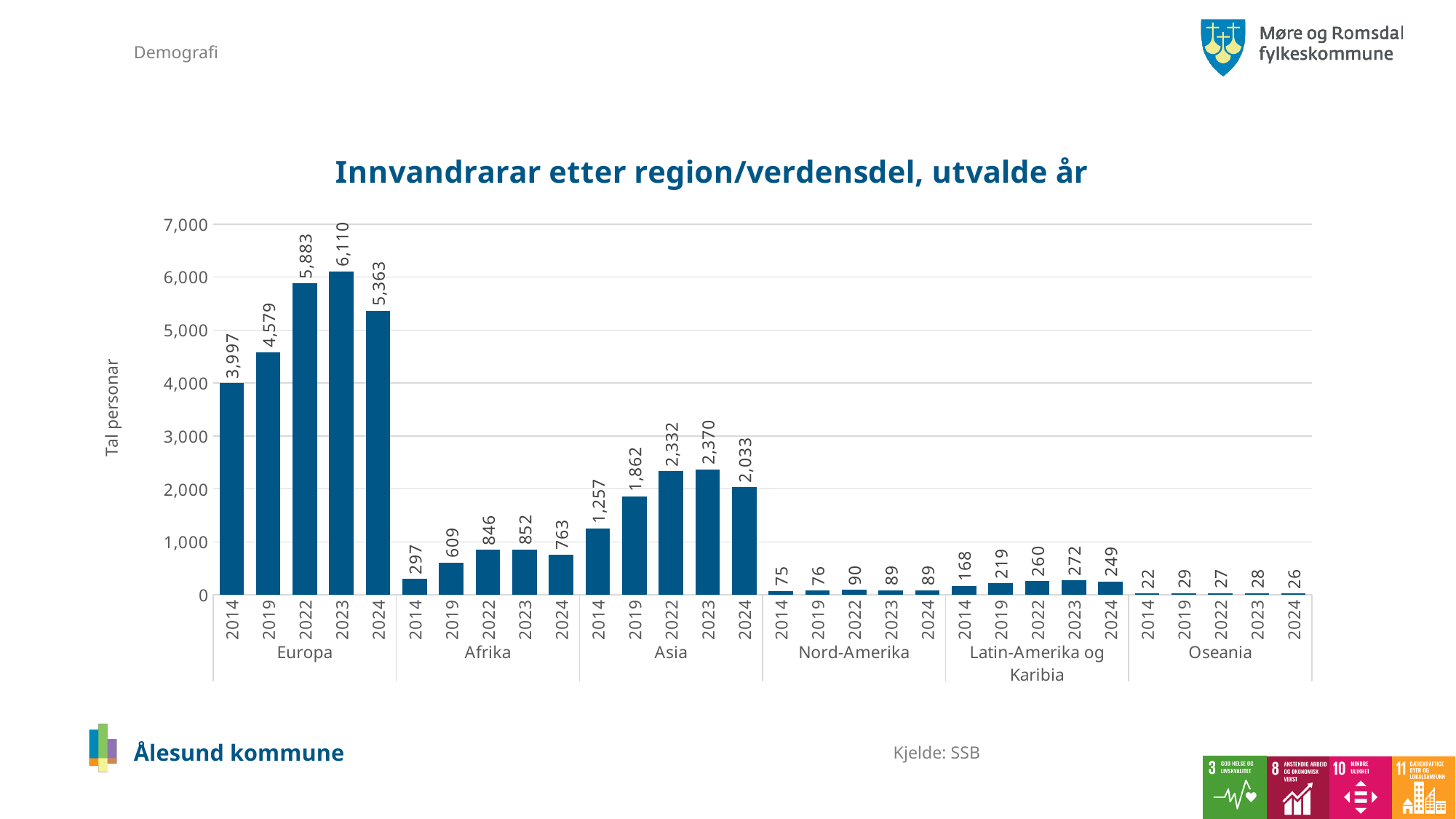
What is the value for Oseania in 2014? 22 What is the value for Asia in 2019? 1,862 Which is larger, the Nord-Amerika value for 2022 or the Latin-Amerika og Karibia value for 2022? Latin-Amerika og Karibia 2022 What kind of chart is this? bar chart What is the title of the chart? Innvandrarar etter region/verdensdel, utvalde år Which year has the lowest value for Afrika? 2014 How many regions are shown on the x axis? 6 Is the value for Europa in 2019 greater or less than 4,000? greater Which region and year has the highest bar? Europa 2023 What is the difference between the Europa values for 2023 and 2024? 747 What is the value for Europa in 2023? 6,110 What is the difference between the Asia values for 2022 and 2014? 1,075